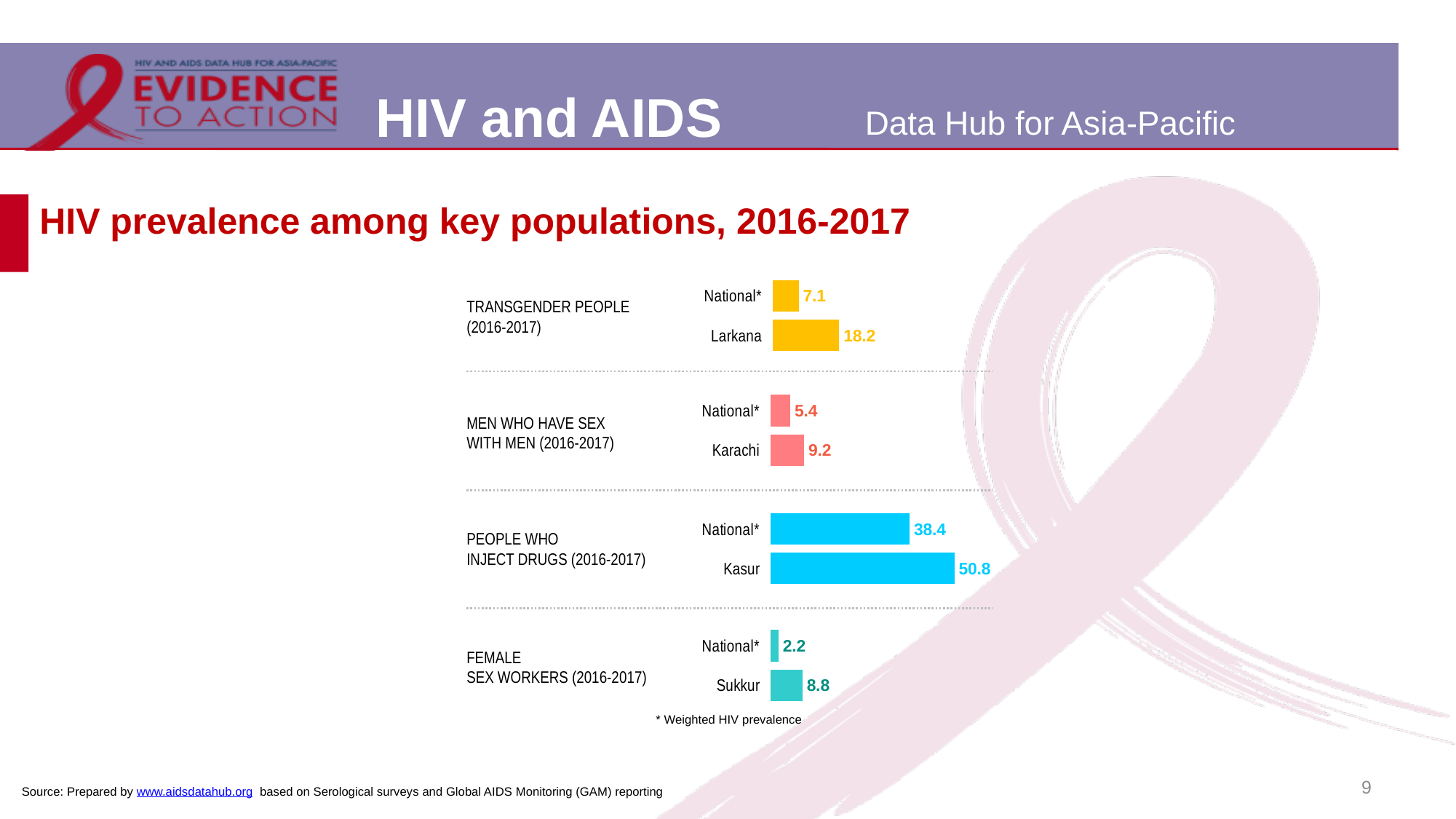
What type of chart is shown on the slide? Bar chart What does the asterisk next to 'National' indicate? Weighted HIV prevalence What is the national weighted HIV prevalence among men who have sex with men? 5.4 What is the HIV prevalence among people who inject drugs in Kasur? 50.8 What is the difference between the Kasur and National* values for people who inject drugs? 12.4 Which is larger: the Karachi value for men who have sex with men or the Sukkur value for female sex workers? Karachi What is the HIV prevalence among female sex workers in Sukkur? 8.8 How many bars are plotted on the chart in total? 8 Which bar shows the highest HIV prevalence on the chart? Kasur (people who inject drugs) Which bar shows the lowest HIV prevalence on the chart? National* (female sex workers) What is the difference between the Larkana and National* values for transgender people? 11.1 What is the HIV prevalence for transgender people in Larkana? 18.2